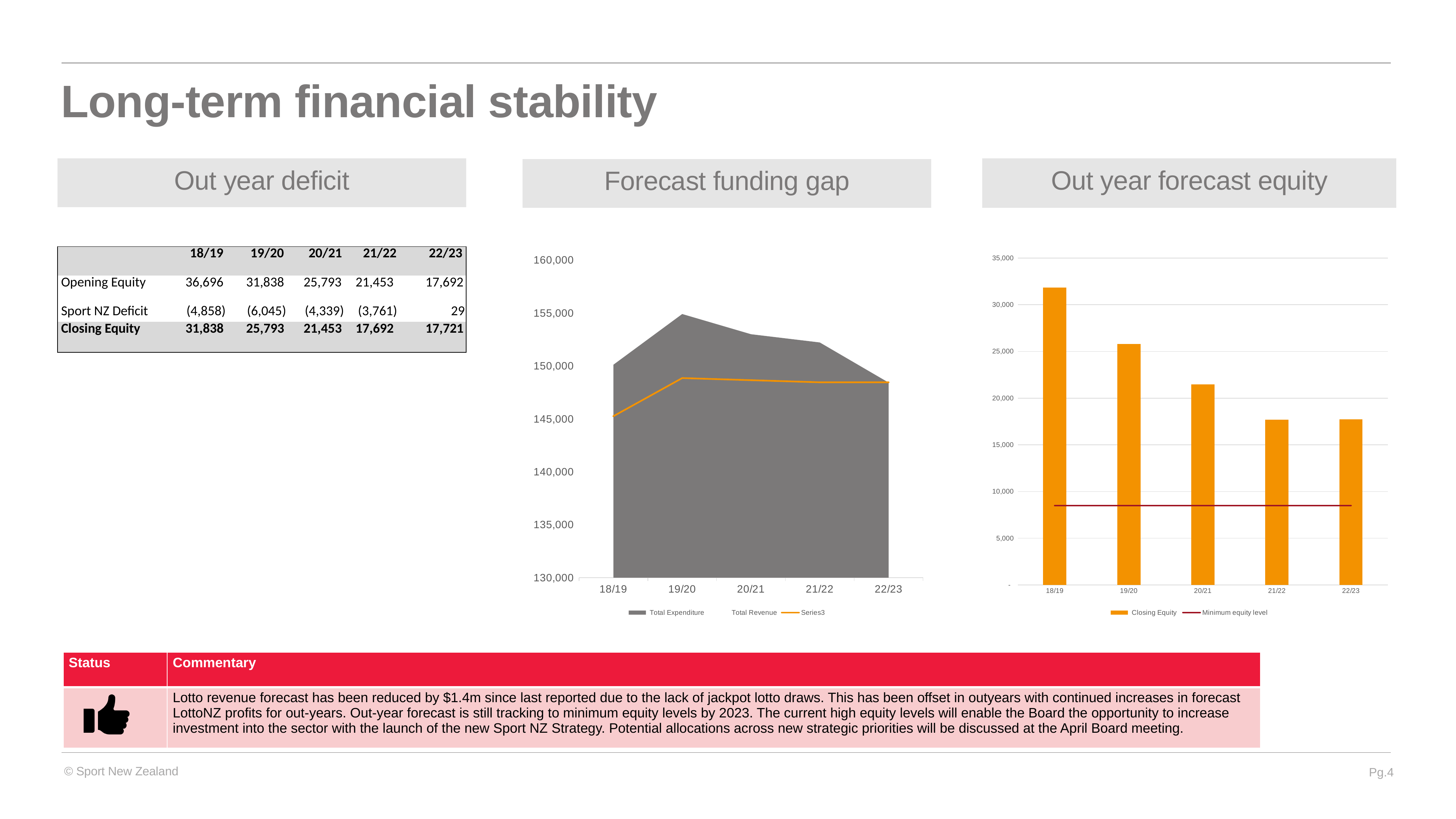
In the 'Out year forecast equity' chart, is the Closing Equity value for 21/22 greater or less than 20,000? less In the 'Out year forecast equity' chart, which is larger, the Closing Equity for 19/20 or for 20/21? 19/20 How many entries does the legend of the 'Forecast funding gap' chart list? 3 In the 'Forecast funding gap' chart, is the Series3 value for 18/19 greater or less than 140,000? greater How many series does the legend of the 'Out year forecast equity' chart list? 2 In the 'Out year forecast equity' chart, is the Closing Equity value for 18/19 greater or less than 30,000? greater What kind of chart is the 'Out year forecast equity' chart? bar chart In the 'Out year forecast equity' chart, which year has the highest Closing Equity bar? 18/19 How many years are shown on the x axis of the 'Forecast funding gap' chart? 5 In the 'Forecast funding gap' chart, in which year does Total Expenditure reach its highest point? 19/20